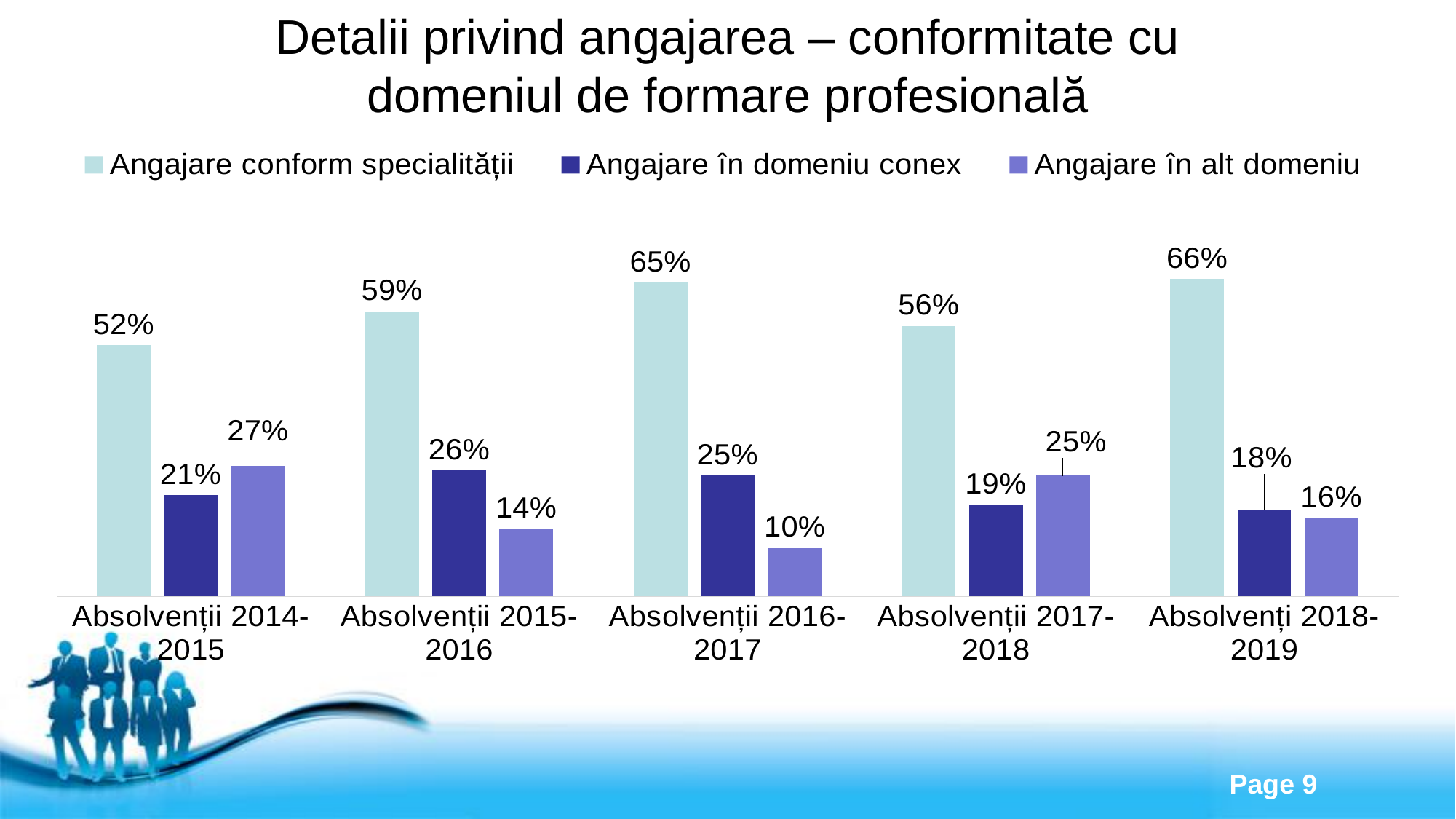
Does the value for "Angajare în alt domeniu" rise or fall from Absolvenții 2014-2015 to Absolvenții 2016-2017? Fall How many series does the legend list? 3 What is the difference between "Angajare conform specialității" for Absolvenți 2018-2019 and for Absolvenții 2014-2015? 14% Which category has the highest value for "Angajare conform specialității"? Absolvenți 2018-2019 What is the title of the chart on the slide? Detalii privind angajarea – conformitate cu domeniul de formare profesională How many graduate cohorts (categories) are shown on the x axis? 5 What is the value for "Angajare conform specialității" for Absolvenții 2016-2017? 65% For Absolvenții 2017-2018, which is larger: "Angajare în domeniu conex" or "Angajare în alt domeniu"? Angajare în alt domeniu What is the value for "Angajare în domeniu conex" for Absolvenți 2018-2019? 18% What is the value for "Angajare în alt domeniu" for Absolvenții 2015-2016? 14% Which category has the lowest value for "Angajare în alt domeniu"? Absolvenții 2016-2017 What kind of chart is shown on the slide? Bar chart